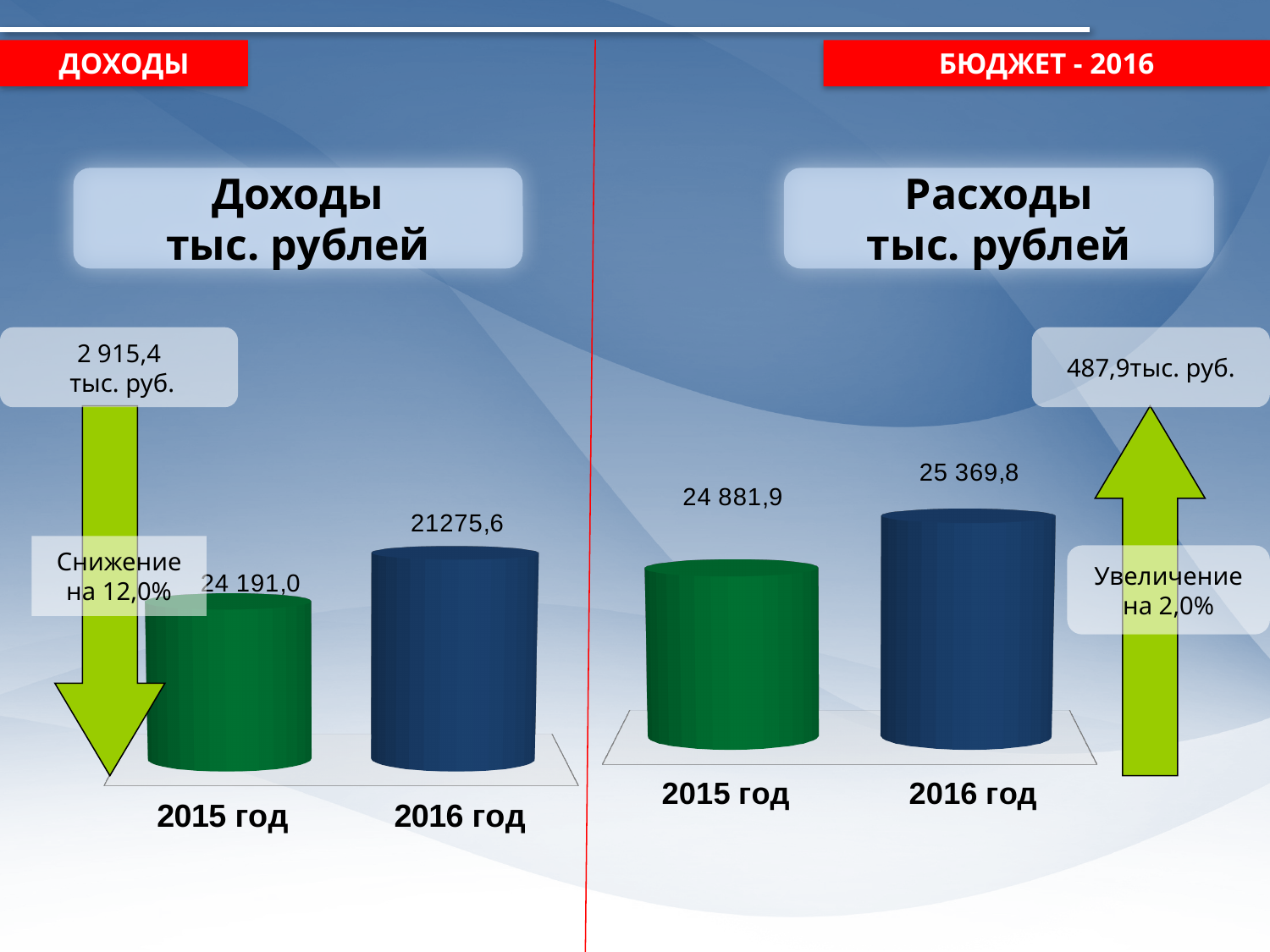
In the 'Расходы тыс. рублей' chart, which year has the lower value? 2015 год How many categories are shown in the 'Расходы тыс. рублей' chart? 2 In the 'Доходы тыс. рублей' chart, by how much does the value for 2015 год exceed the value for 2016 год? 2 915,4 In the 'Доходы тыс. рублей' chart, which year has the higher value? 2015 год In the 'Доходы тыс. рублей' chart, what is the value for 2016 год? 21275,6 In the 'Доходы тыс. рублей' chart, do the values rise or fall from 2015 год to 2016 год? fall In the 'Расходы тыс. рублей' chart, is the value for 2016 год larger or smaller than the value for 2015 год? larger In the 'Расходы тыс. рублей' chart, what is the value for 2016 год? 25 369,8 In the 'Расходы тыс. рублей' chart, what is the value for 2015 год? 24 881,9 In the 'Расходы тыс. рублей' chart, what is the difference between the 2016 год and 2015 год values? 487,9 In the 'Доходы тыс. рублей' chart, what is the value for 2015 год? 24 191,0 What kind of chart is the 'Доходы тыс. рублей' chart? bar chart